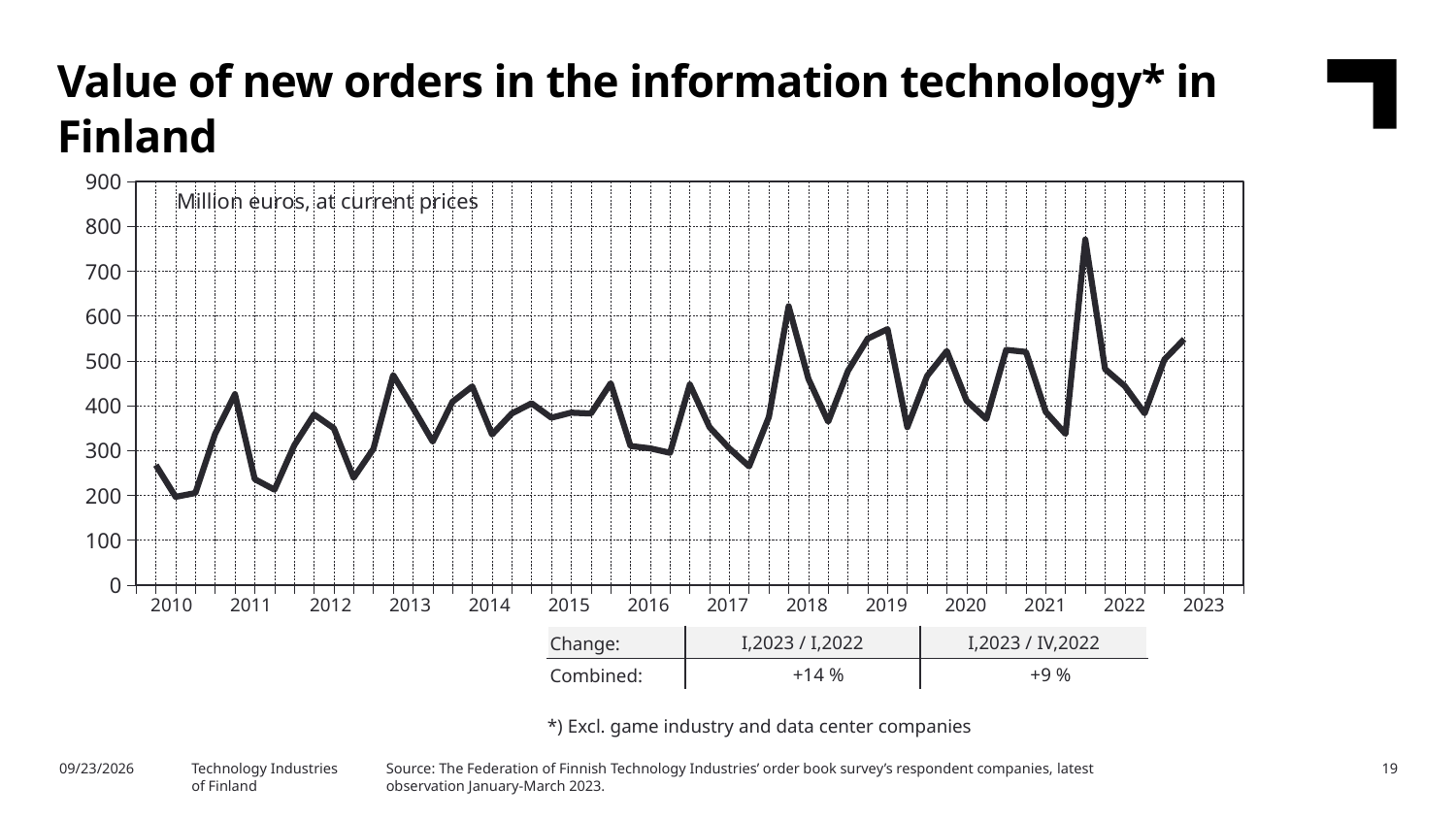
Is the highest peak of the line, in 2021, greater or less than 700? greater Is the first value of the line, at the start of 2010, greater or less than 300? less Which is higher: the peak of the line in 2019 or the peak in 2013? 2019 Overall, does the value of new orders rise or fall from 2010 to 2023? rise What unit is the chart measured in, according to the label inside the plot area? Million euros, at current prices How many year labels are shown on the x axis? 14 Is the peak of the line in 2018 greater or less than 500? greater In which year does the line reach its highest peak? 2021 Which is higher: the peak of the line in 2021 or the peak in 2018? 2021 What kind of chart is shown on the slide? line chart